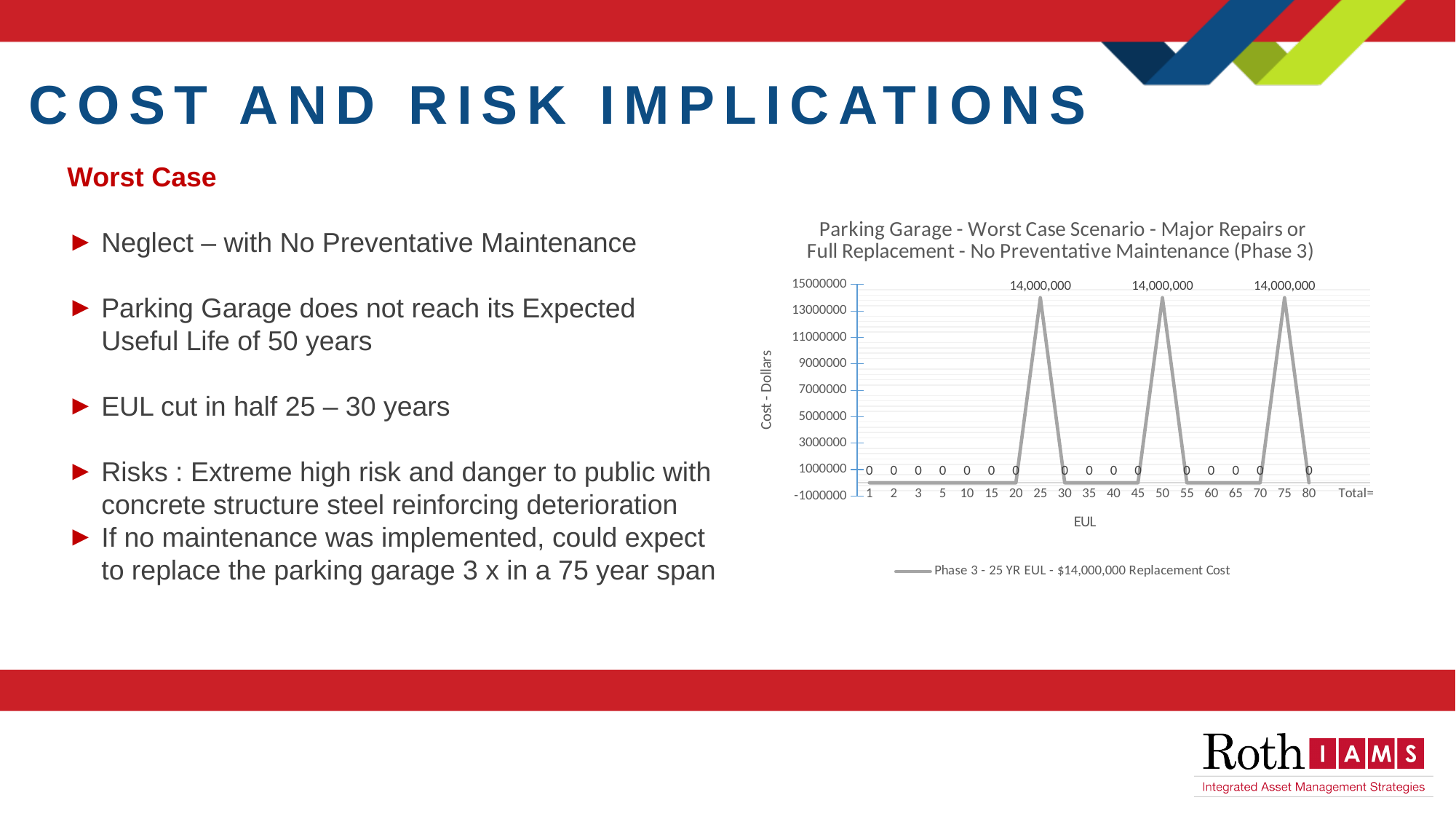
How many series does the legend list? 1 What is the title of the vertical axis? Cost - Dollars Is the value at EUL 75 greater or less than 13000000? greater What is the difference between the value at EUL 25 and the value at EUL 20? 14,000,000 How many category labels are shown along the x axis? 20 What is the cost value at EUL 50? 14,000,000 How many data points are labelled 14,000,000? 3 Which has the larger value, EUL 75 or EUL 80? EUL 75 What is the cost value at EUL 25? 14,000,000 What is the cost value at EUL 30? 0 What type of chart is shown on the slide? line chart What is the name of the series in the legend? Phase 3 - 25 YR EUL - $14,000,000 Replacement Cost